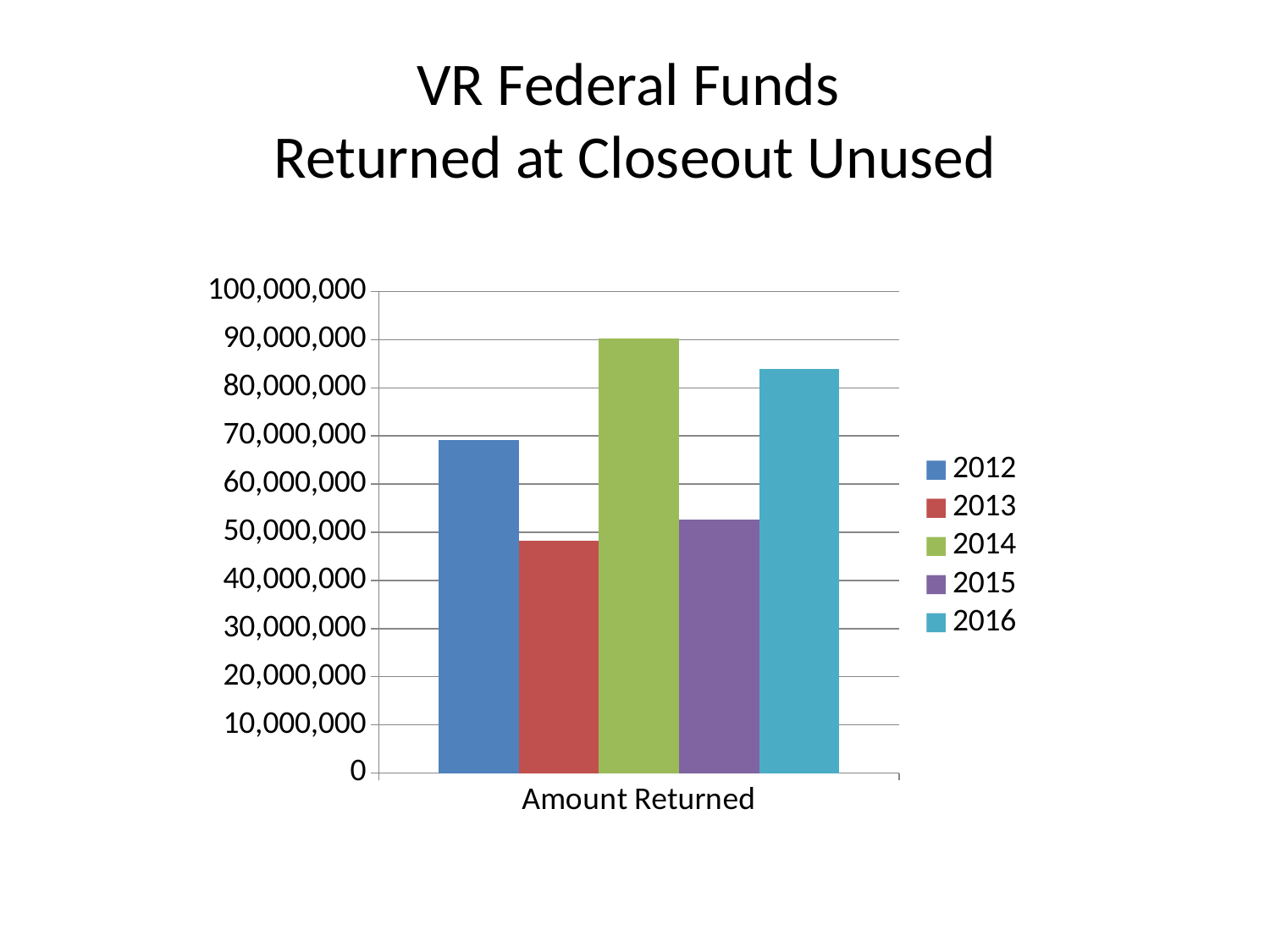
Which year has the lowest amount returned? 2013 How many series does the legend list? 5 Is the value for 2013 greater or less than 60,000,000? less Is the value for 2014 greater or less than 80,000,000? greater Is the value for 2015 greater or less than 60,000,000? less Which is larger, the value for 2012 or the value for 2016? 2016 Which year has the highest amount returned? 2014 What is the title of the chart on the slide? VR Federal Funds Returned at Closeout Unused What kind of chart is shown on the slide? bar chart Which is larger, the value for 2013 or the value for 2015? 2015